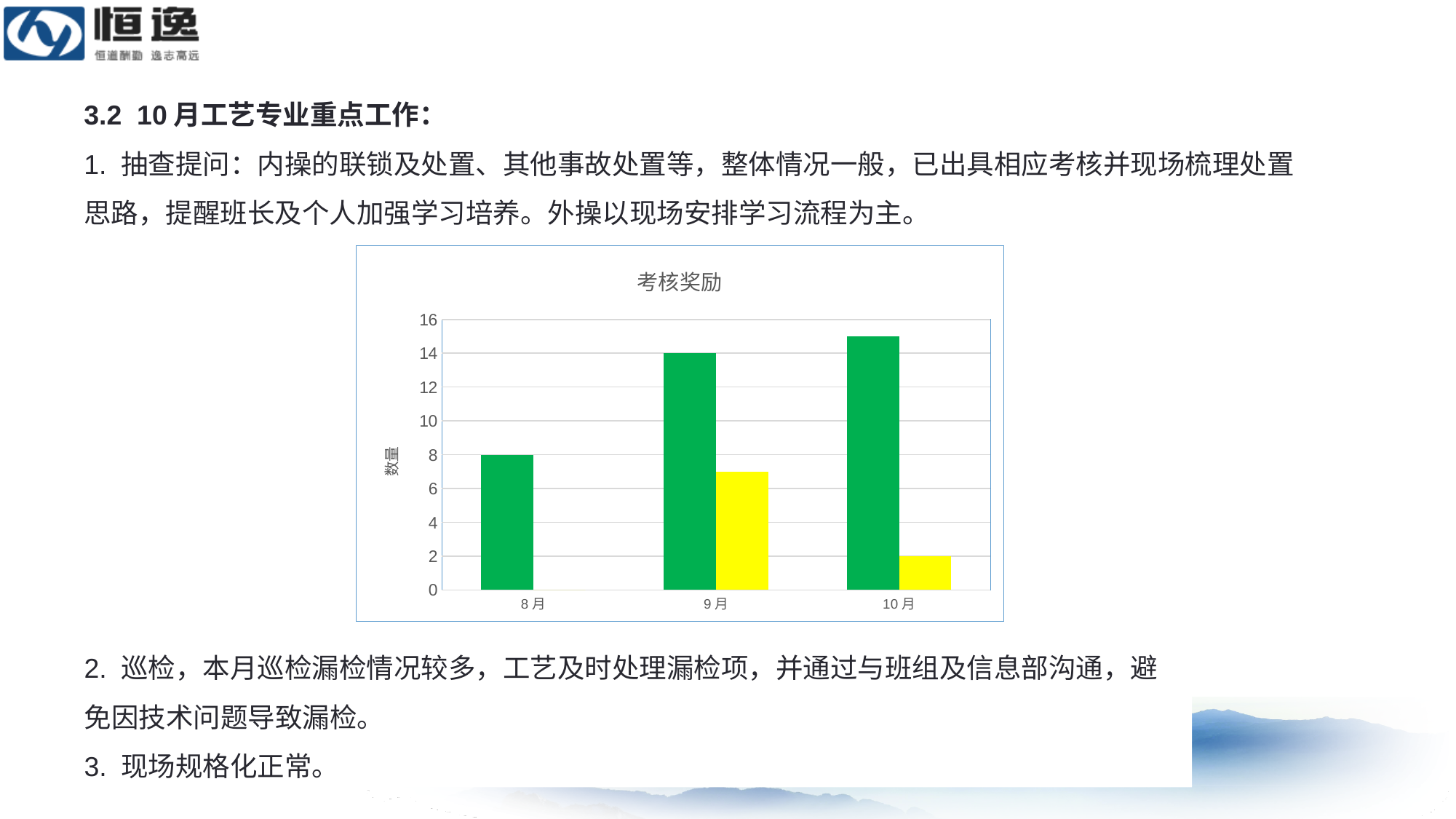
What is the difference between the green bar for 9月 and the green bar for 8月? 6 What is the value of the green bar for 9月? 14 How many categories are shown on the x axis of the chart? 3 Do the green bars rise or fall from 8月 to 10月? rise Is the value of the yellow bar for 9月 greater or less than 6? greater Which month has the lowest green bar? 8月 Is the value of the green bar for 10月 greater or less than 14? greater What is the value of the yellow bar for 10月? 2 What is the value of the green bar for 8月? 8 What type of chart is shown on the slide? bar chart Which month has the highest green bar? 10月 What is the title of the chart? 考核奖励